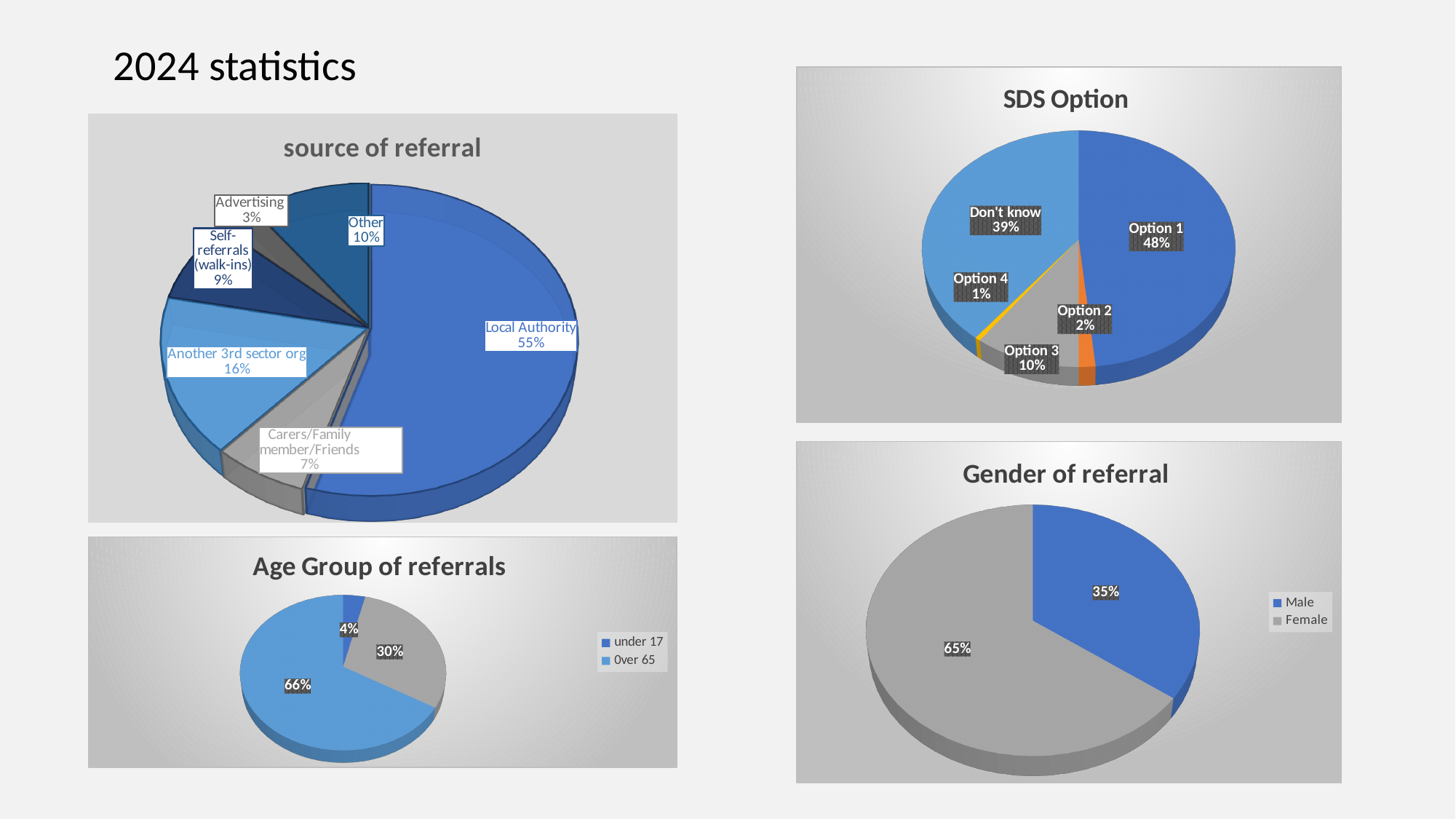
In the 'source of referral' chart, what share of referrals came from Local Authority? 55% In the 'Age Group of referrals' chart, how many entries does the legend list? 2 What type of chart is the 'Gender of referral' chart? Pie chart In the 'SDS Option' chart, which is larger, Don't know or Option 3? Don't know In the 'source of referral' chart, what is the difference in percentage points between Another 3rd sector org and Carers/Family member/Friends? 9 In the 'SDS Option' chart, how many categories are shown? 5 In the 'SDS Option' chart, which option has the lowest share? Option 4 In the 'Gender of referral' chart, what percentage of referrals are Female? 65% In the 'source of referral' chart, which source has the smallest share? Advertising In the 'Age Group of referrals' chart, what percentage of referrals are Over 65? 66% In the 'source of referral' chart, how many slices does the pie have? 6 In the 'SDS Option' chart, what percentage chose Option 1? 48%